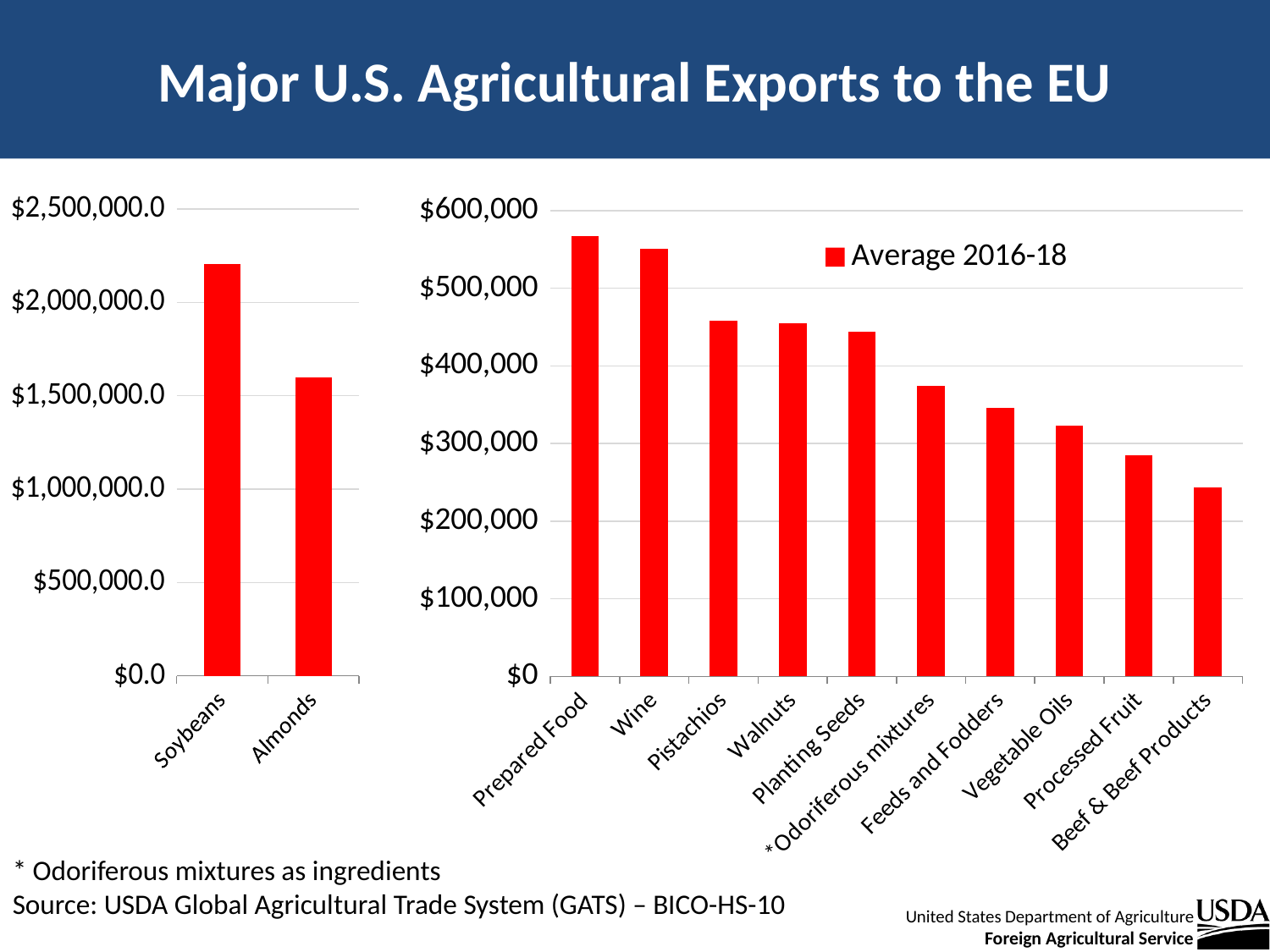
How many categories are shown on the right chart? 10 On the right chart, which has the larger value, Planting Seeds or Feeds and Fodders? Planting Seeds On the left chart, is the value for Soybeans greater or less than $2,000,000.0? greater On the left chart, is the value for Almonds greater or less than $1,500,000.0? greater On the right chart, which category has the highest value? Prepared Food On the left chart, which category has the higher value, Soybeans or Almonds? Soybeans How many categories are shown on the left chart? 2 On the right chart, do the values rise or fall from left to right along the x axis? fall On the right chart, is the value for Wine greater or less than $500,000? greater On the right chart, which category has the lowest value? Beef & Beef Products